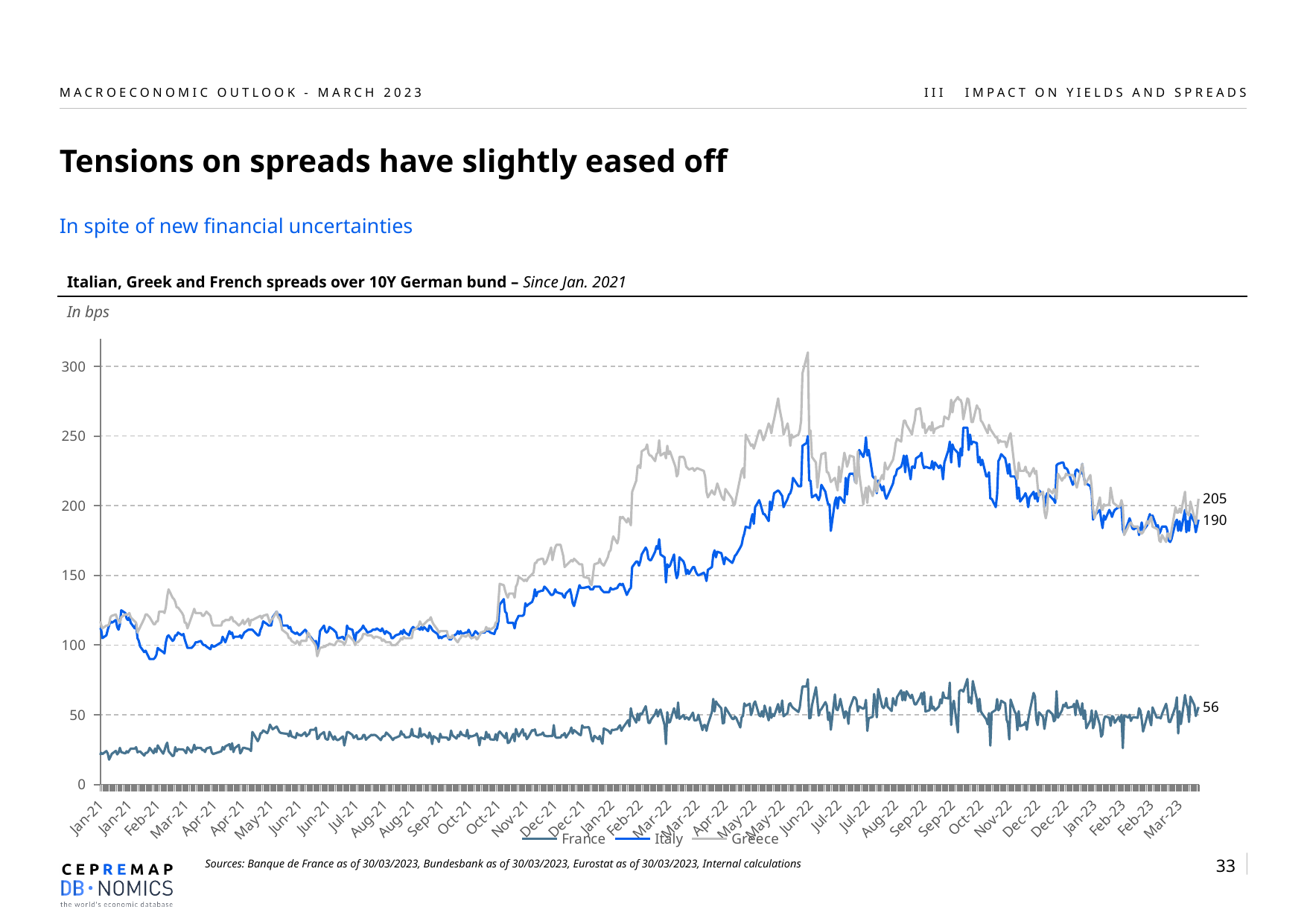
Which series has the highest value at the right end of the chart? Greece What is the difference between the latest values for Greece and Italy? 15 What is the latest value shown for France at the right end of the chart? 56 At the right end of the chart, is the value for Greece or Italy larger? Greece Which series has the lowest value at the right end of the chart? France What is the difference between the latest values for Italy and France? 134 Is the peak value for Greece around Jun-22 greater or less than 300? greater What kind of chart is shown on the slide? Line chart What is the latest value shown for Italy at the right end of the chart? 190 Is the value for France in Jan-21 greater or less than 50? less What is the latest value shown for Greece at the right end of the chart? 205 How many series does the legend list? 3